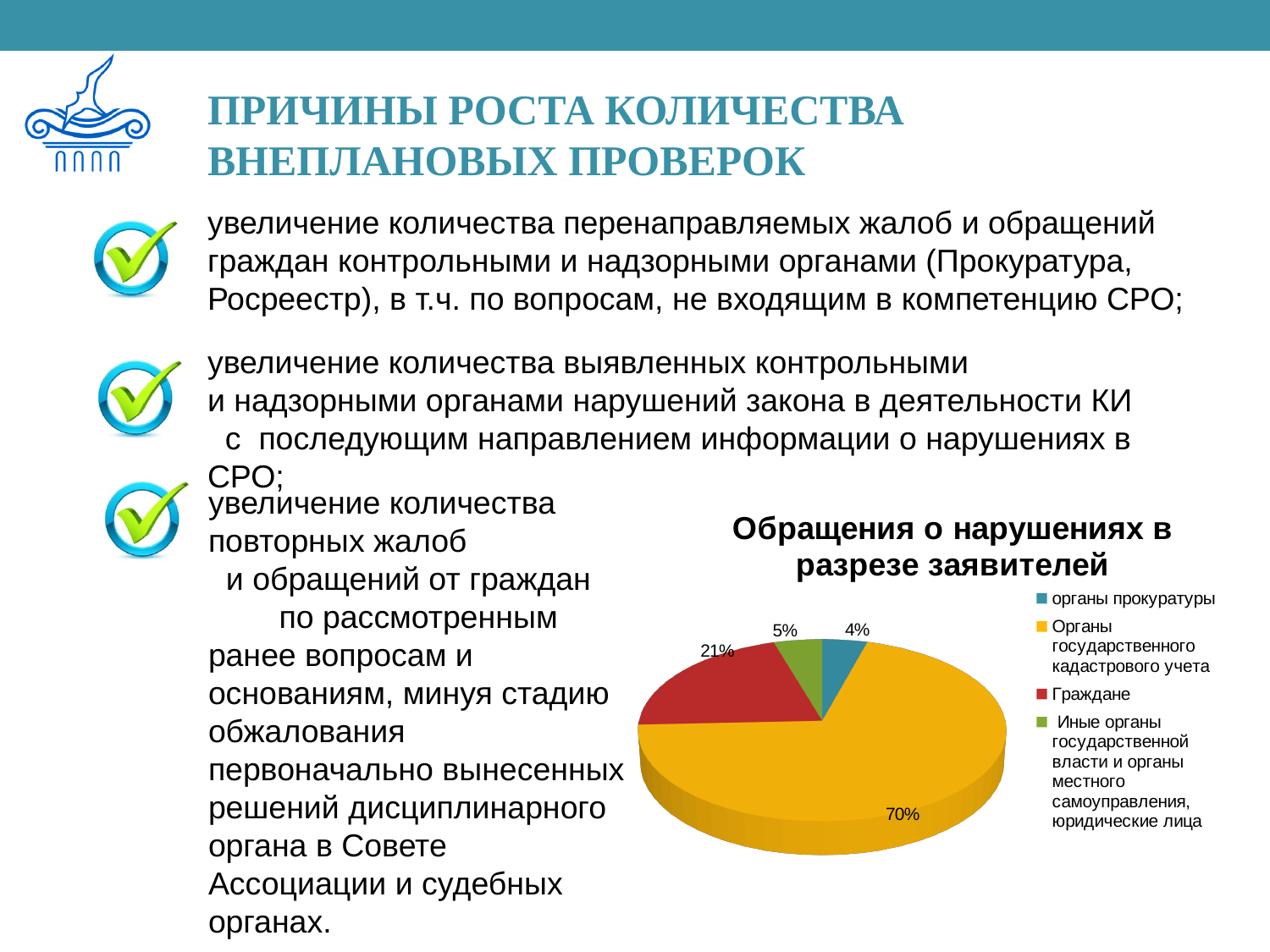
What type of chart is shown on the slide? Pie chart What share of the pie is attributed to Граждане? 21% How many slices does the pie chart have? 4 How many entries does the chart legend list? 4 Which category has the largest share of the pie? Органы государственного кадастрового учета What share of the pie is attributed to Иные органы государственной власти и органы местного самоуправления, юридические лица? 5% Which is larger: the share for Граждане or the share for органы прокуратуры? Граждане Which category has the smallest share of the pie? органы прокуратуры What is the title of the chart on the slide? Обращения о нарушениях в разрезе заявителей What share of the pie is attributed to органы прокуратуры? 4% What is the difference in percentage points between the share for Органы государственного кадастрового учета and the share for Граждане? 49